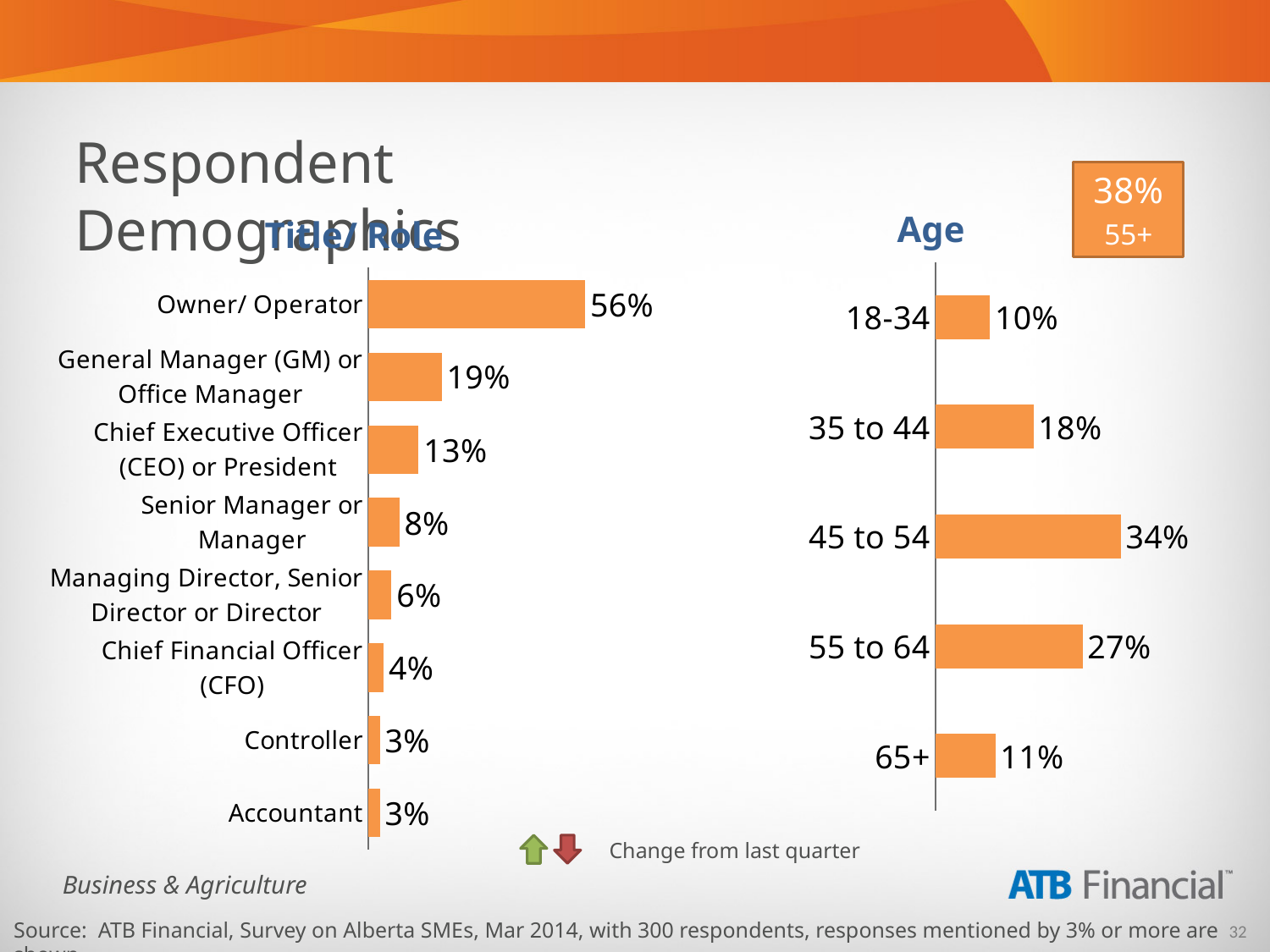
In the Title/Role chart, what percentage of respondents are Chief Financial Officer (CFO)? 4% In the Title/Role chart, what is the difference between the Owner/ Operator percentage and the General Manager (GM) or Office Manager percentage? 37% In the Age chart, which group has a larger share of respondents, 18-34 or 65+? 65+ In the Age chart, which age group has the highest percentage of respondents? 45 to 54 What type of chart is the Age chart? Bar chart In the Age chart, what percentage of respondents are aged 55 to 64? 27% In the Title/Role chart, what percentage of respondents are Owner/ Operator? 56% In the Title/Role chart, which has a larger percentage, Chief Executive Officer (CEO) or President, or Senior Manager or Manager? Chief Executive Officer (CEO) or President In the Title/Role chart, which role has the highest percentage of respondents? Owner/ Operator How many age groups are shown in the Age chart? 5 In the Age chart, what is the difference between the 45 to 54 group and the 35 to 44 group? 16% How many roles are shown in the Title/Role chart? 8